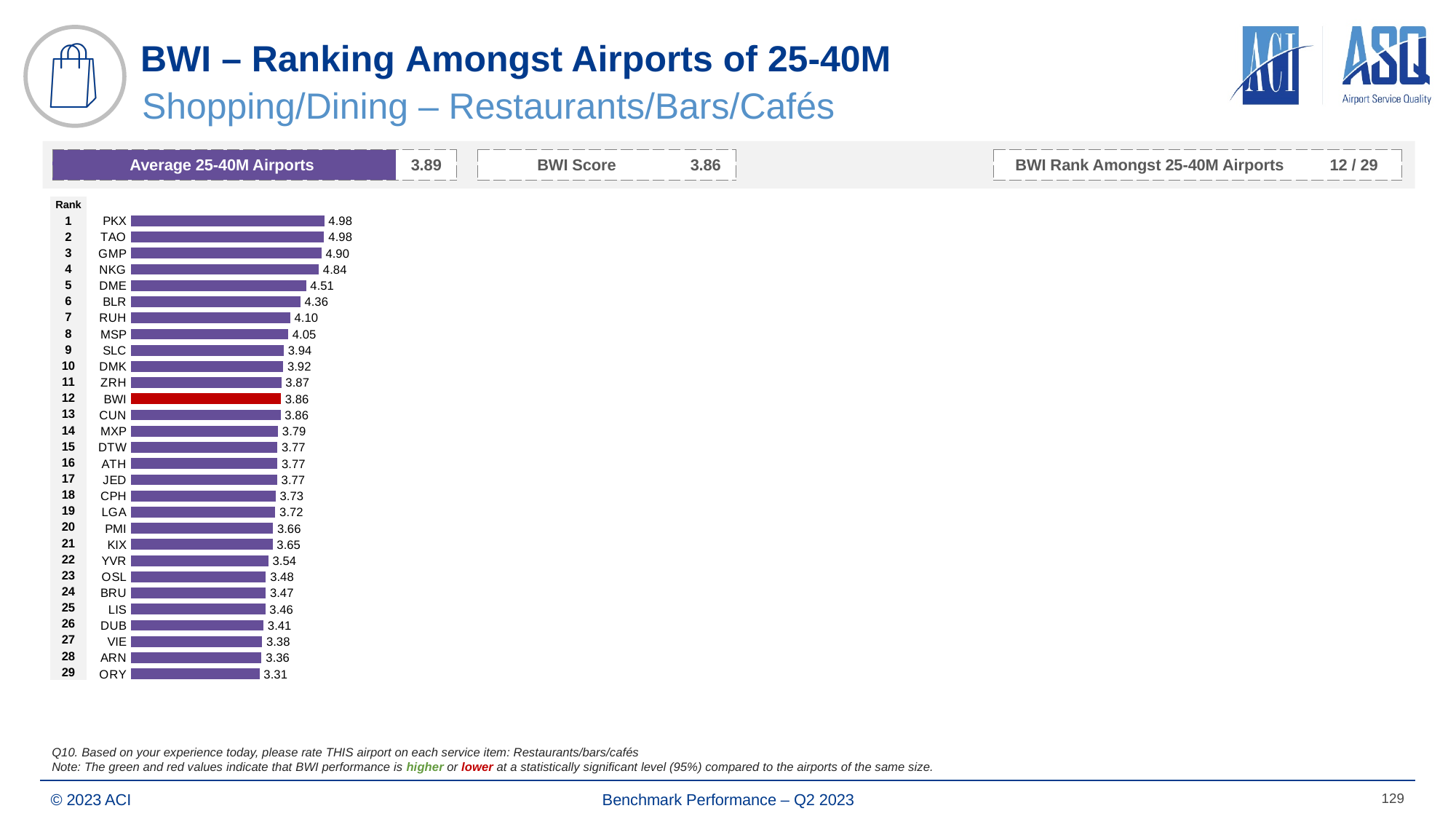
Do the scores rise or fall as rank increases from 1 to 29? fall What is the score for BWI? 3.86 What is the difference between the scores of BWI and ZRH? 0.01 Which airport has the lowest score? ORY Which airport's bar is coloured red? BWI What is the difference between the scores of PKX and ORY? 1.67 How many airports are ranked in the chart? 29 Which has a higher score, YVR or KIX? KIX Which has a higher score, RUH or MSP? RUH What is the score for DME? 4.51 What kind of chart is shown on the slide? bar chart What is the score for ORY? 3.31